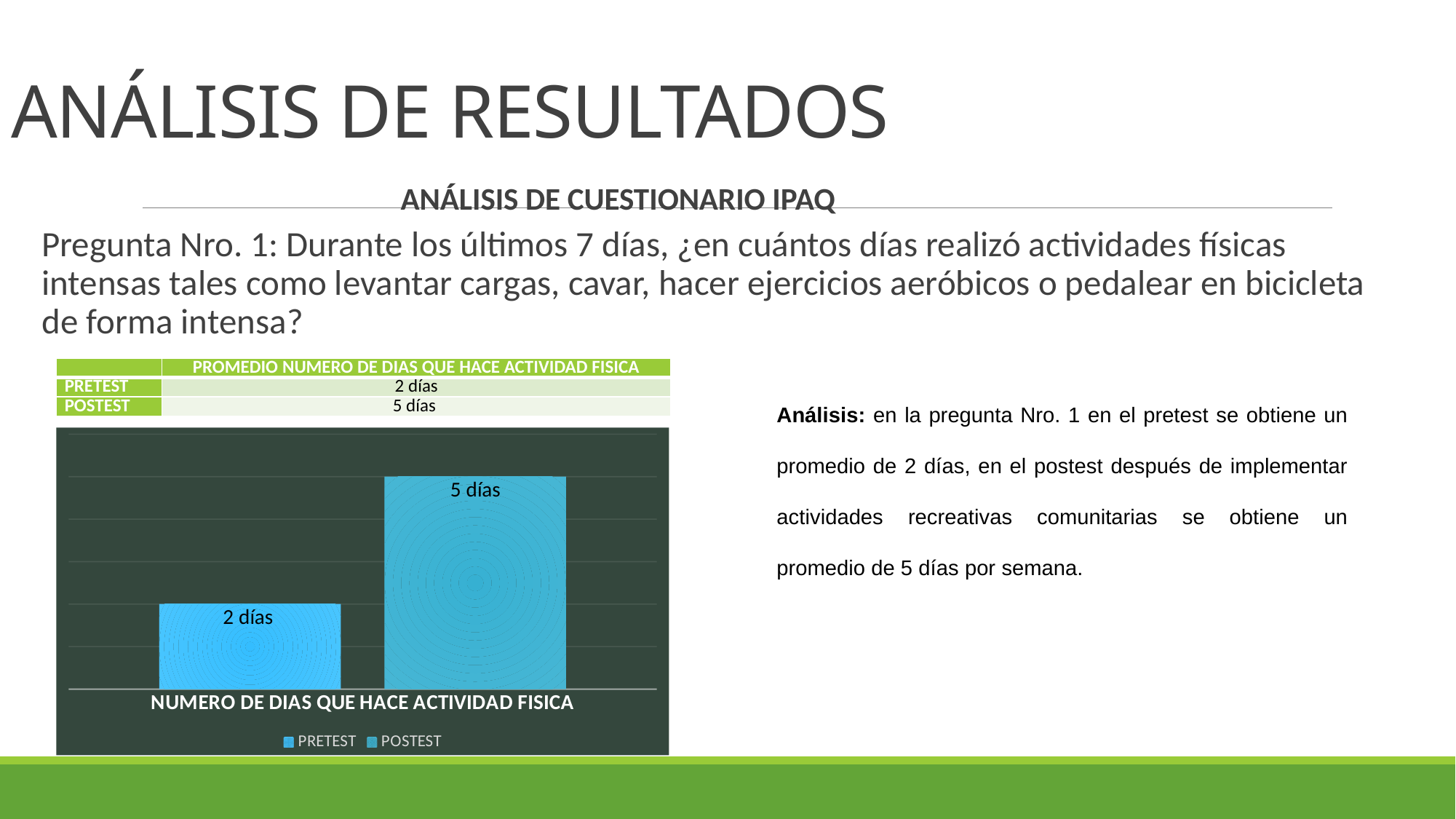
Which series has the lowest value in the chart? PRETEST What are the two legend entries of the chart? PRETEST and POSTEST Which series has the higher value, PRETEST or POSTEST? POSTEST How many bars are plotted in the chart? 2 What is the value for POSTEST in the chart? 5 días Which series has the highest value in the chart? POSTEST What is the category label shown below the bars? NUMERO DE DIAS QUE HACE ACTIVIDAD FISICA What is the difference in days between POSTEST and PRETEST? 3 días What kind of chart is shown on the slide? Bar chart How many series does the legend list? 2 What is the value for PRETEST in the chart? 2 días